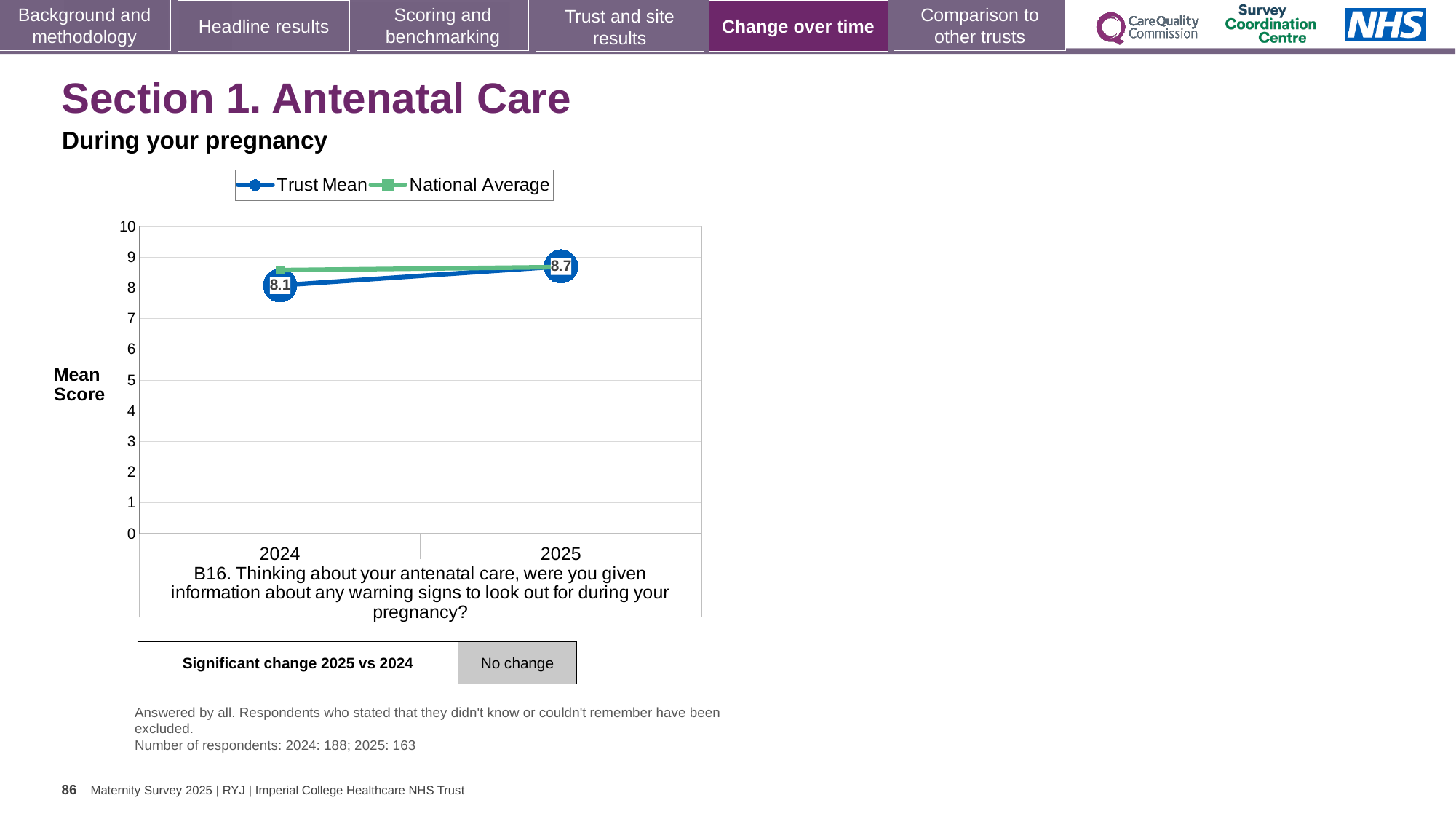
How many years are shown on the x axis of the chart? 2 Does the Trust Mean rise or fall from 2024 to 2025? rise By how much did the Trust Mean change from 2024 to 2025? 0.6 What is the Trust Mean value for 2024? 8.1 Is the National Average value for 2024 greater or less than 8? greater Is the National Average value for 2025 greater or less than 9? less What is the Trust Mean value for 2025? 8.7 What does the 'Significant change 2025 vs 2024' box below the chart say? No change How many series does the chart legend list? 2 In 2024, which is higher: the Trust Mean or the National Average? National Average What type of chart is shown on the slide? line chart Which year has the higher Trust Mean, 2024 or 2025? 2025